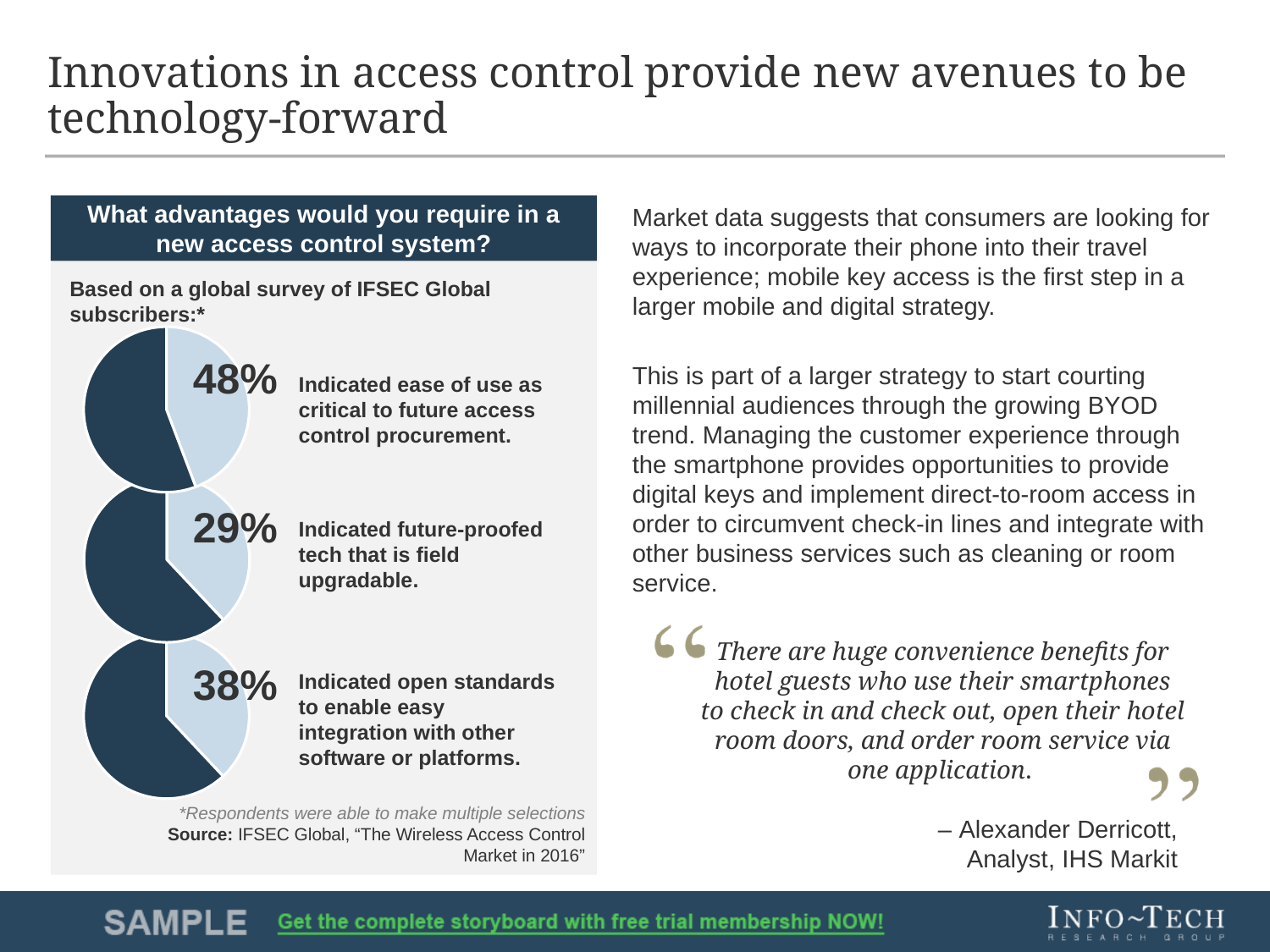
In the middle pie chart, what percentage of respondents indicated future-proofed tech that is field upgradable? 29% In the top pie chart, what share of the pie does the light blue slice represent? 48% What is the difference in percentage points between the ease of use pie chart and the open standards pie chart? 10 percentage points Which is larger: the percentage for open standards or the percentage for future-proofed tech? Open standards (38%) In the bottom pie chart, what percentage of respondents indicated open standards to enable easy integration with other software or platforms? 38% How many pie charts are shown on the slide? 3 In the top pie chart, what percentage of respondents indicated ease of use as critical to future access control procurement? 48% What is the difference in percentage points between the ease of use pie chart (48%) and the future-proofed tech pie chart (29%)? 19 percentage points What is the title of the survey question shown above the pie charts? What advantages would you require in a new access control system? Across the three pie charts, which advantage has the highest percentage of respondents? Ease of use (48%) Across the three pie charts, which advantage has the lowest percentage of respondents? Future-proofed tech that is field upgradable (29%) What kind of chart is used to show the survey results on the left of the slide? Pie chart